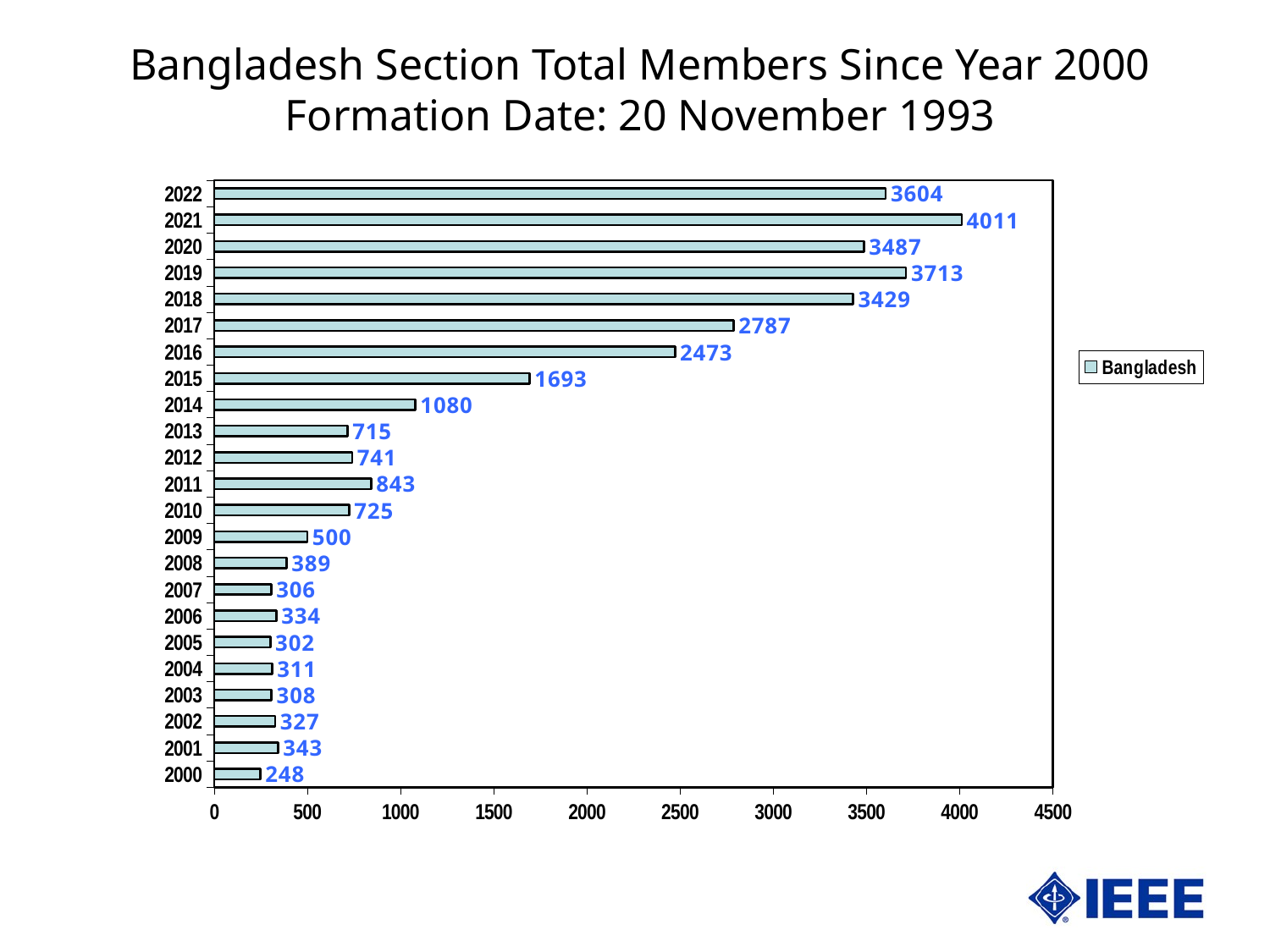
Is the value for 2017 greater or less than 2500? greater What is the total number of members for 2000? 248 What kind of chart is shown on the slide? Bar chart Which year has more members, 2012 or 2013? 2012 What is the total number of members for 2021? 4011 What series name does the legend show? Bangladesh Which year has the highest number of members? 2021 What is the difference in members between 2019 and 2018? 284 What is the total number of members for 2014? 1080 What is the difference in members between 2021 and 2022? 407 Which year has the lowest number of members? 2000 How many years are shown on the chart? 23